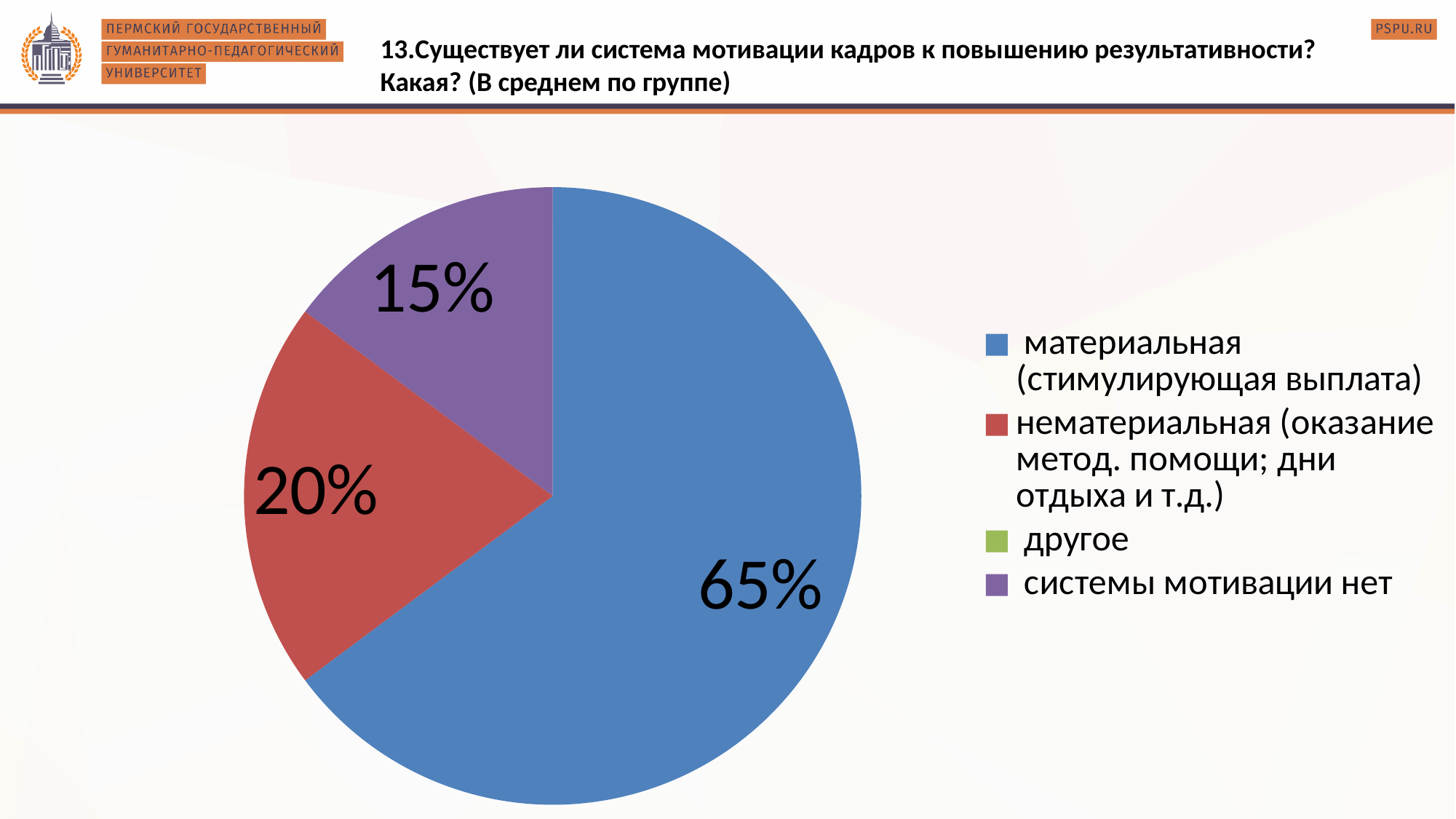
What share of the pie does "системы мотивации нет" have? 15% Which of the visible slices is the smallest? системы мотивации нет How many slices with a printed percentage are visible in the pie? 3 What share of the pie does "материальная (стимулирующая выплата)" have? 65% What type of chart is shown on the slide? pie chart What colour is the slice for "системы мотивации нет"? purple What share of the pie does "нематериальная (оказание метод. помощи; дни отдыха и т.д.)" have? 20% What is the difference between the share for "материальная (стимулирующая выплата)" and the share for "нематериальная (оказание метод. помощи; дни отдыха и т.д.)"? 45% What is the difference between the share for "нематериальная (оказание метод. помощи; дни отдыха и т.д.)" and the share for "системы мотивации нет"? 5% Which category has the largest slice of the pie? материальная (стимулирующая выплата) How many entries does the legend list? 4 Which is larger: the share for "нематериальная (оказание метод. помощи; дни отдыха и т.д.)" or the share for "системы мотивации нет"? нематериальная (оказание метод. помощи; дни отдыха и т.д.)